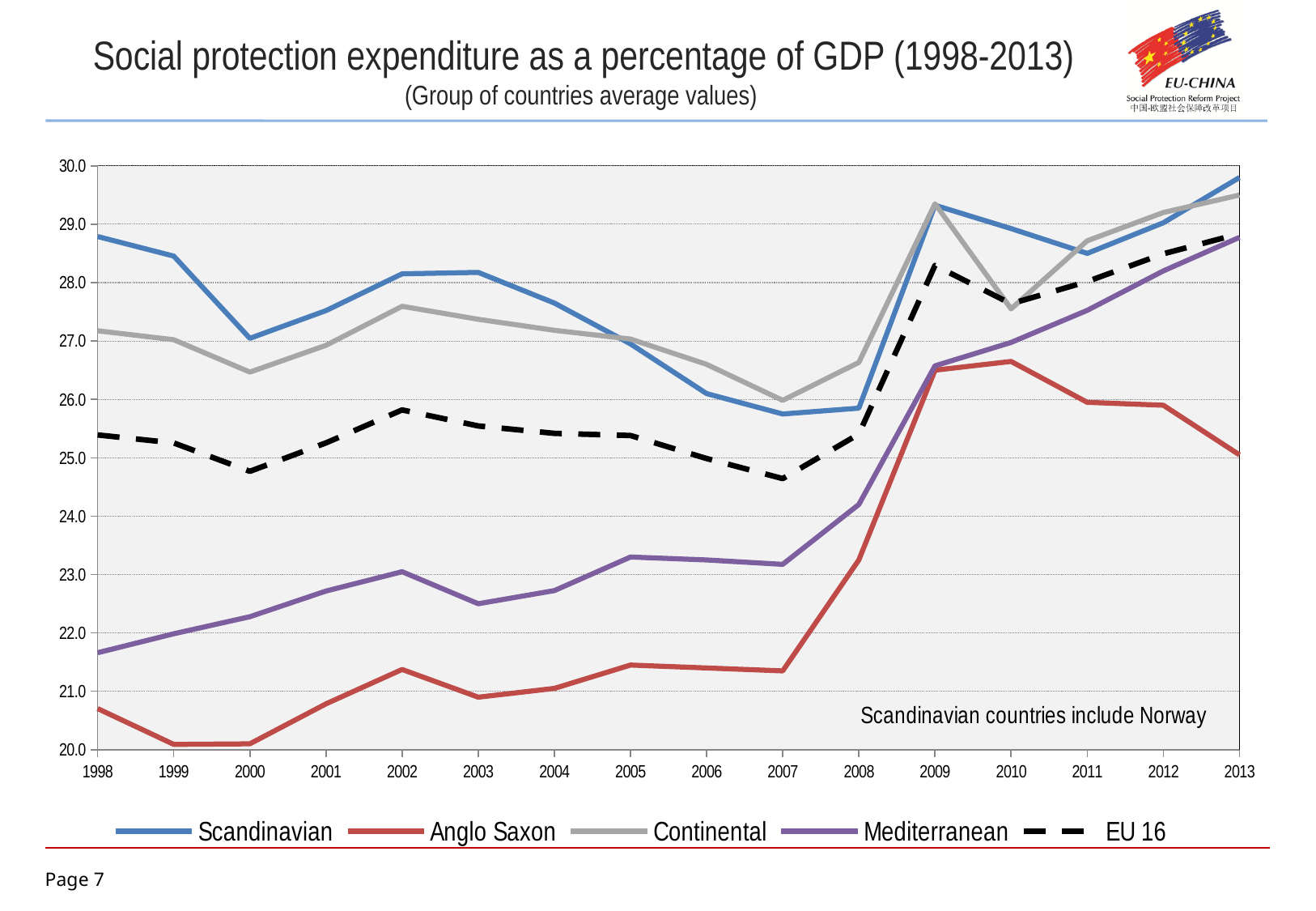
Which series has the highest value in 2013? Scandinavian What kind of chart is shown on the slide? Line chart Is the value for Scandinavian in 2013 greater or less than 29.0? greater Which series is drawn as a black dashed line? EU 16 Which series has the lowest value in 1998? Anglo Saxon Is the value for Anglo Saxon in 1998 greater or less than 21.0? less How many series does the legend list? 5 Is the value for EU 16 in 2007 greater or less than 25.0? less In 2009, which is larger: the Scandinavian value or the Anglo Saxon value? Scandinavian How many years are plotted along the x axis? 16 Does the Anglo Saxon line rise or fall from 2010 to 2013? Fall